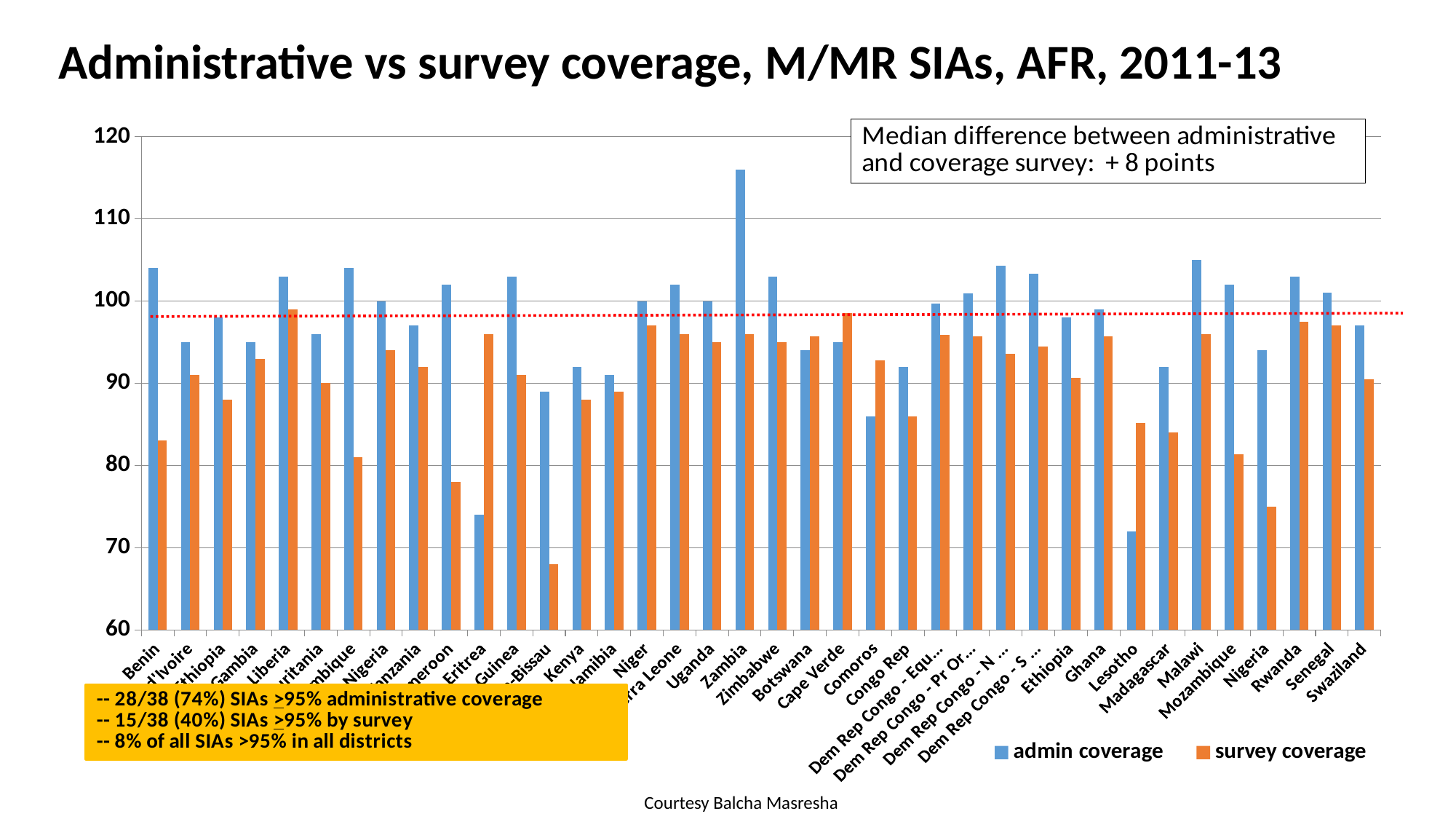
Is the admin coverage value for Eritrea greater or less than 80? less Is the admin coverage value for Zambia greater or less than 110? greater Which country has the lowest survey coverage? Guinea-Bissau How many series does the legend list? 2 Is the survey coverage value for Benin greater or less than 90? less What kind of chart is shown on the slide? bar chart For Benin, which is larger: admin coverage or survey coverage? admin coverage What are the two series named in the legend? admin coverage and survey coverage For Eritrea, which is larger: admin coverage or survey coverage? survey coverage Which country has the highest admin coverage? Zambia For Lesotho, which is larger: admin coverage or survey coverage? survey coverage